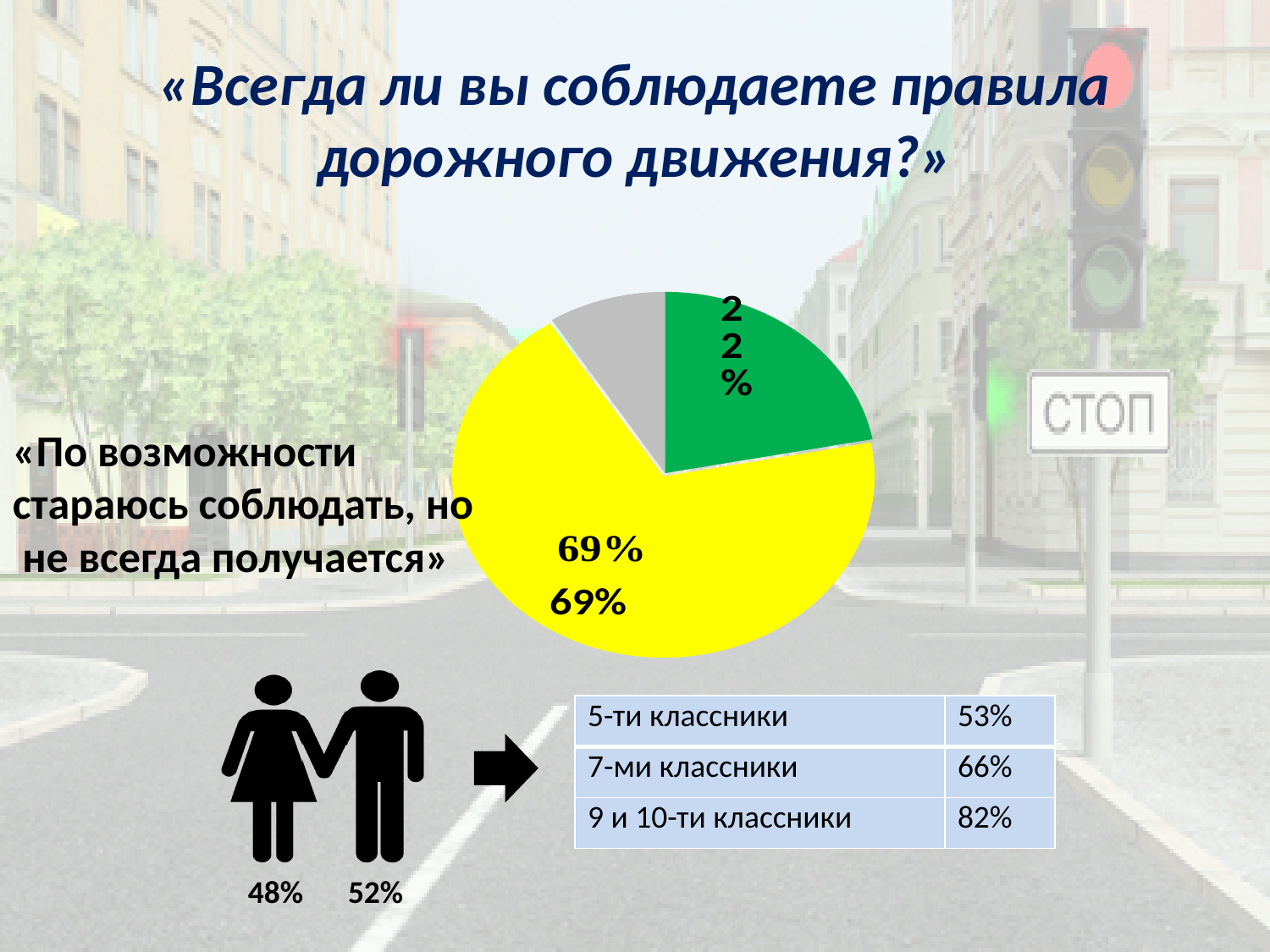
Which slice of the pie chart has no percentage label? the grey slice By how many percentage points does the yellow slice exceed the green slice in the pie chart? 47 percentage points What share of the pie does the yellow slice represent? 69% What percentage is shown on the green slice of the pie chart? 22% What percentage is shown on the yellow slice of the pie chart? 69% What kind of chart is shown on the slide? pie chart Which slice of the pie chart is the largest? the yellow slice (69%) How many slices does the pie chart have? 3 What colour is the slice labelled 22% in the pie chart? green Which slice of the pie chart is the smallest? the grey slice Which is larger in the pie chart, the yellow slice or the green slice? the yellow slice